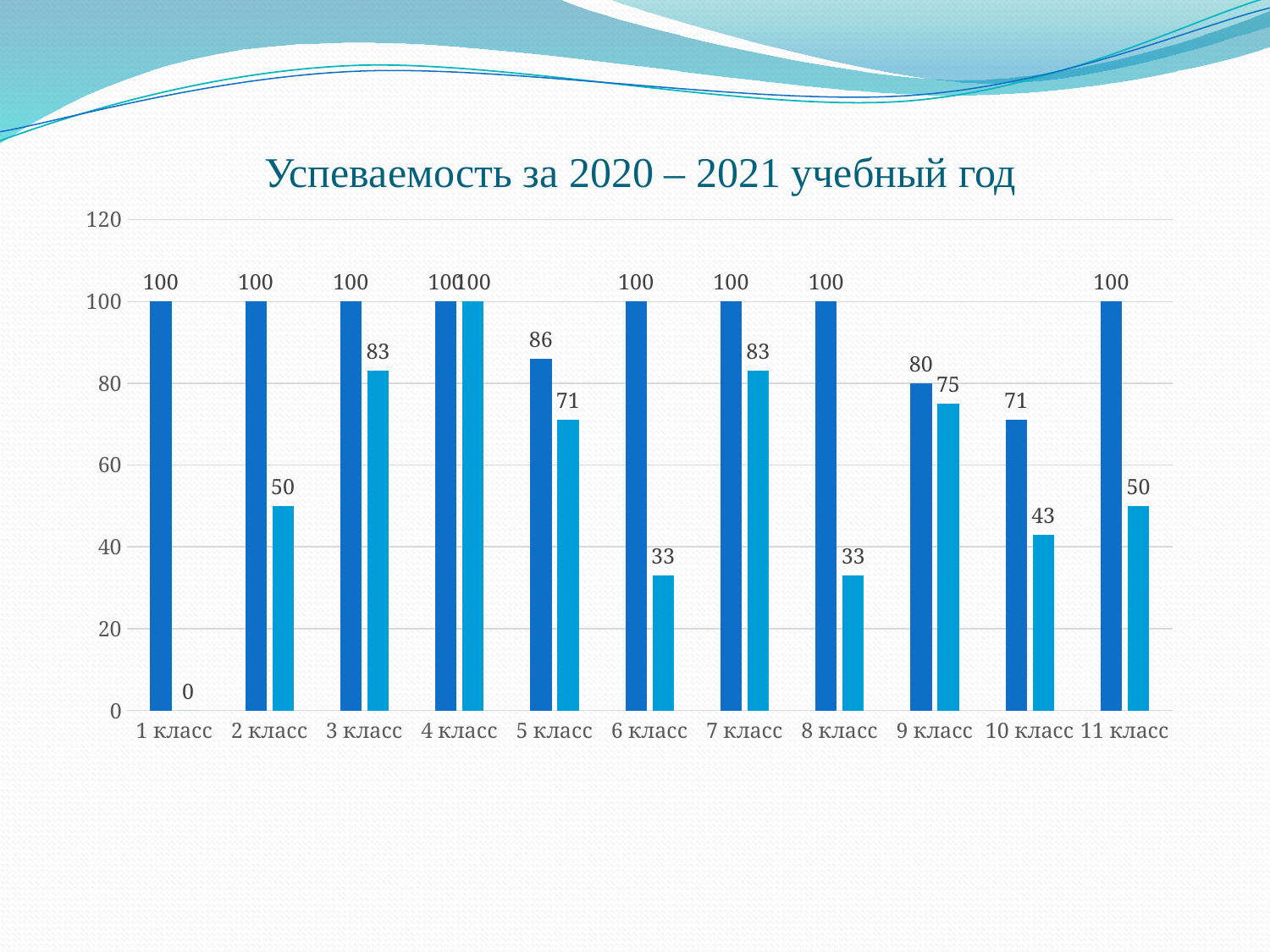
What is the value of the light blue (second) bar for 10 класс? 43 For which class are both bars equal to 100? 4 класс What type of chart is shown on the slide? bar chart Which class has the lowest value for the dark blue (first) bar? 10 класс What is the value of the light blue (second) bar for 2 класс? 50 How many classes (categories) are shown on the x axis? 11 What is the difference between the dark blue and light blue bars for 9 класс? 5 Which is larger: the light blue bar for 3 класс or the light blue bar for 11 класс? 3 класс What is the value of the light blue (second) bar for 1 класс? 0 What is the title of the chart? Успеваемость за 2020 – 2021 учебный год What is the value of the dark blue (first) bar for 5 класс? 86 What is the difference between the dark blue and light blue bars for 6 класс? 67